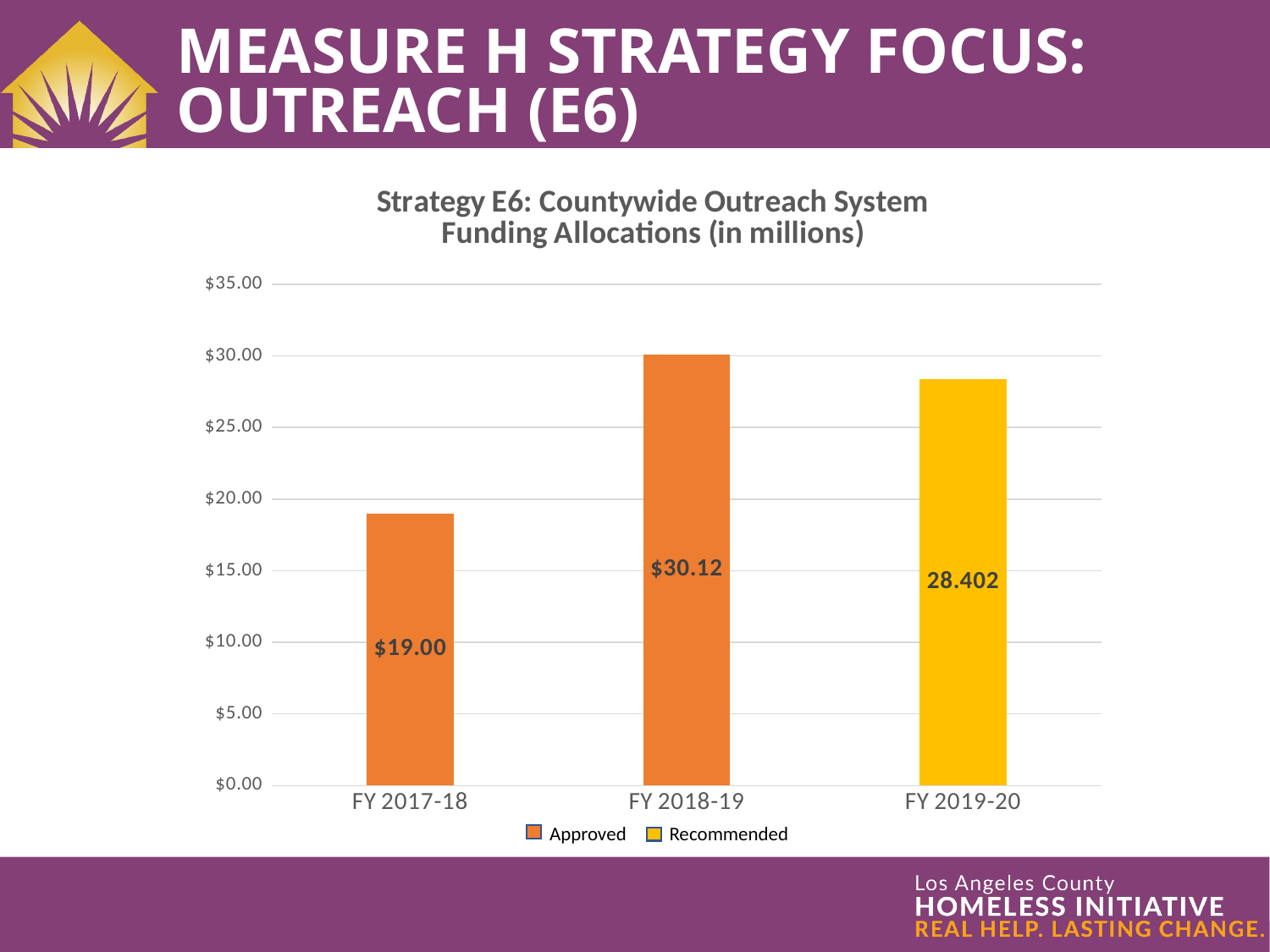
What is the funding allocation for FY 2019-20? 28.402 Is the value for FY 2019-20 greater or less than $25.00? greater How many fiscal years are shown on the x axis? 3 Which fiscal year has the highest funding allocation? FY 2018-19 What is the funding allocation for FY 2017-18? $19.00 What kind of chart is shown on the slide? bar chart How many series does the legend list? 2 What is the difference between the FY 2018-19 and FY 2017-18 allocations? $11.12 Which is larger, the allocation for FY 2018-19 or FY 2019-20? FY 2018-19 Which series does the FY 2019-20 bar belong to, according to the legend? Recommended Which fiscal year has the lowest funding allocation? FY 2017-18 What is the funding allocation for FY 2018-19? $30.12